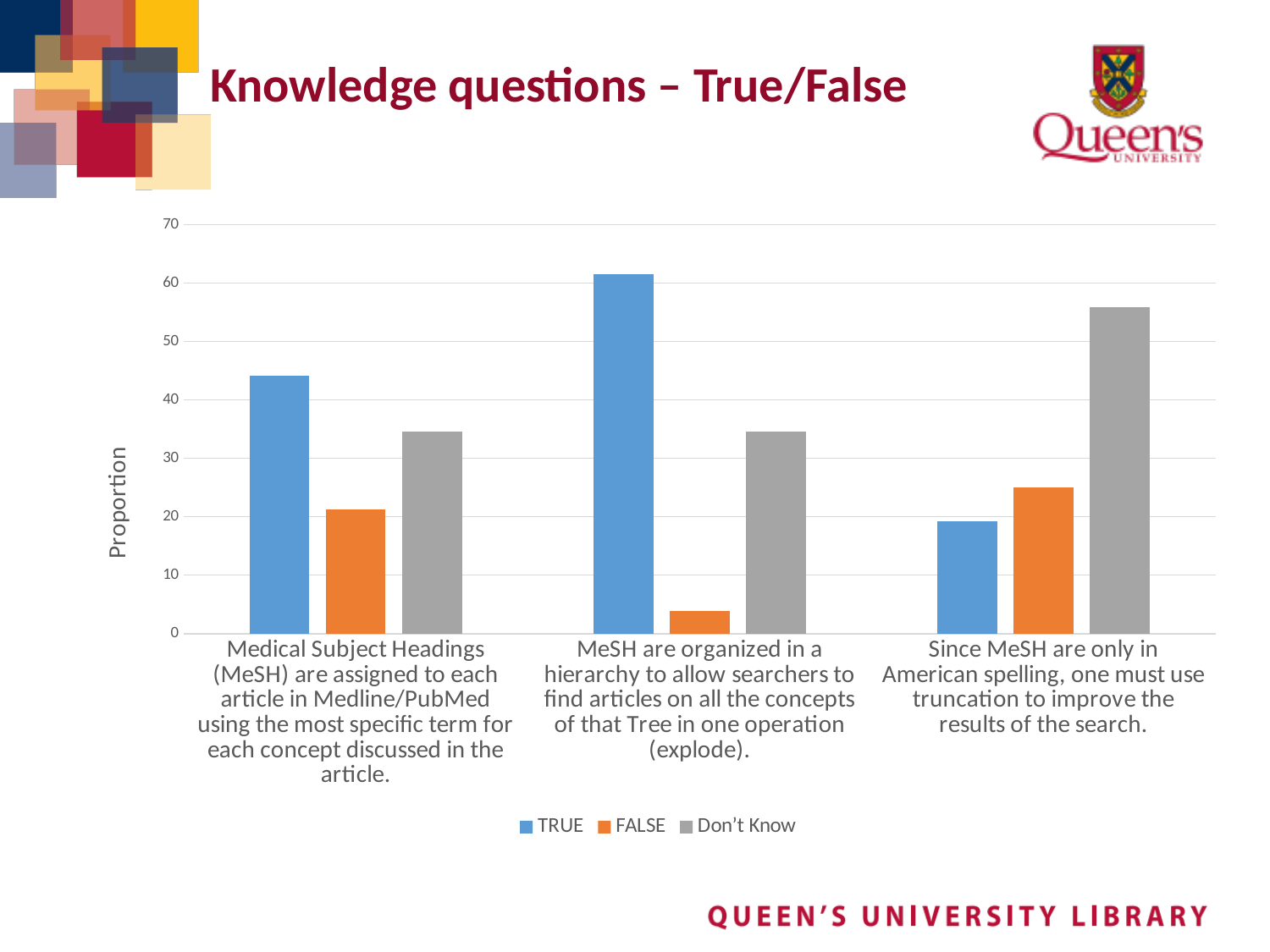
For the statement 'Since MeSH are only in American spelling, one must use truncation to improve the results of the search.', which response has the highest proportion? Don't Know For the statement 'MeSH are organized in a hierarchy...', which response has the lowest proportion? FALSE What kind of chart is shown on the slide? bar chart How many question categories are shown along the x axis? 3 Which series is shown in orange in the legend? FALSE Is the TRUE proportion for the statement 'MeSH are organized in a hierarchy...' greater or less than 60? greater Is the Don't Know proportion for the statement 'Since MeSH are only in American spelling...' greater or less than 50? greater What is the label of the y axis? Proportion For the statement 'Medical Subject Headings (MeSH) are assigned to each article...', is the TRUE proportion larger or the FALSE proportion larger? TRUE How many series does the legend list? 3 For the statement 'MeSH are organized in a hierarchy to allow searchers to find articles on all the concepts of that Tree in one operation (explode).', which response has the highest proportion? TRUE Is the FALSE proportion for the statement 'MeSH are organized in a hierarchy...' greater or less than 10? less